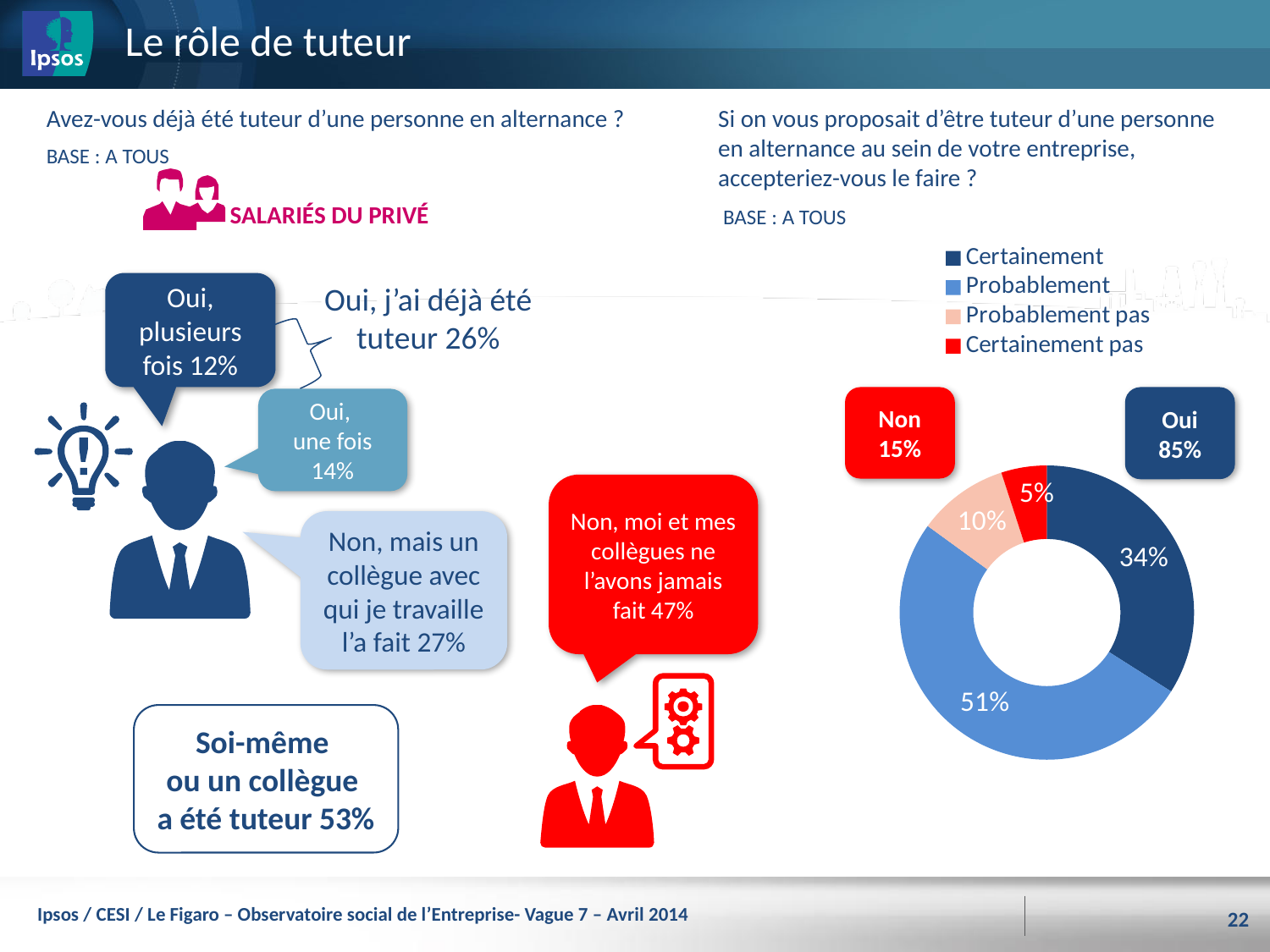
In the doughnut chart, what share of respondents answered "Certainement pas"? 5% In the doughnut chart, what share of respondents answered "Probablement"? 51% In the doughnut chart, which is larger: "Probablement pas" or "Certainement pas"? Probablement pas What kind of chart is shown on the right side of the slide? Doughnut chart Which category has the largest slice in the doughnut chart? Probablement Which category has the smallest slice in the doughnut chart? Certainement pas In the doughnut chart, what share of respondents answered "Certainement"? 34% According to the labels next to the doughnut chart, what is the total share of "Oui" answers? 85% What colour is the "Certainement pas" slice in the doughnut chart? Red How many categories does the legend of the doughnut chart list? 4 In the doughnut chart, what is the difference between the "Probablement" and "Certainement" shares? 17 percentage points In the doughnut chart, what share of respondents answered "Probablement pas"? 10%